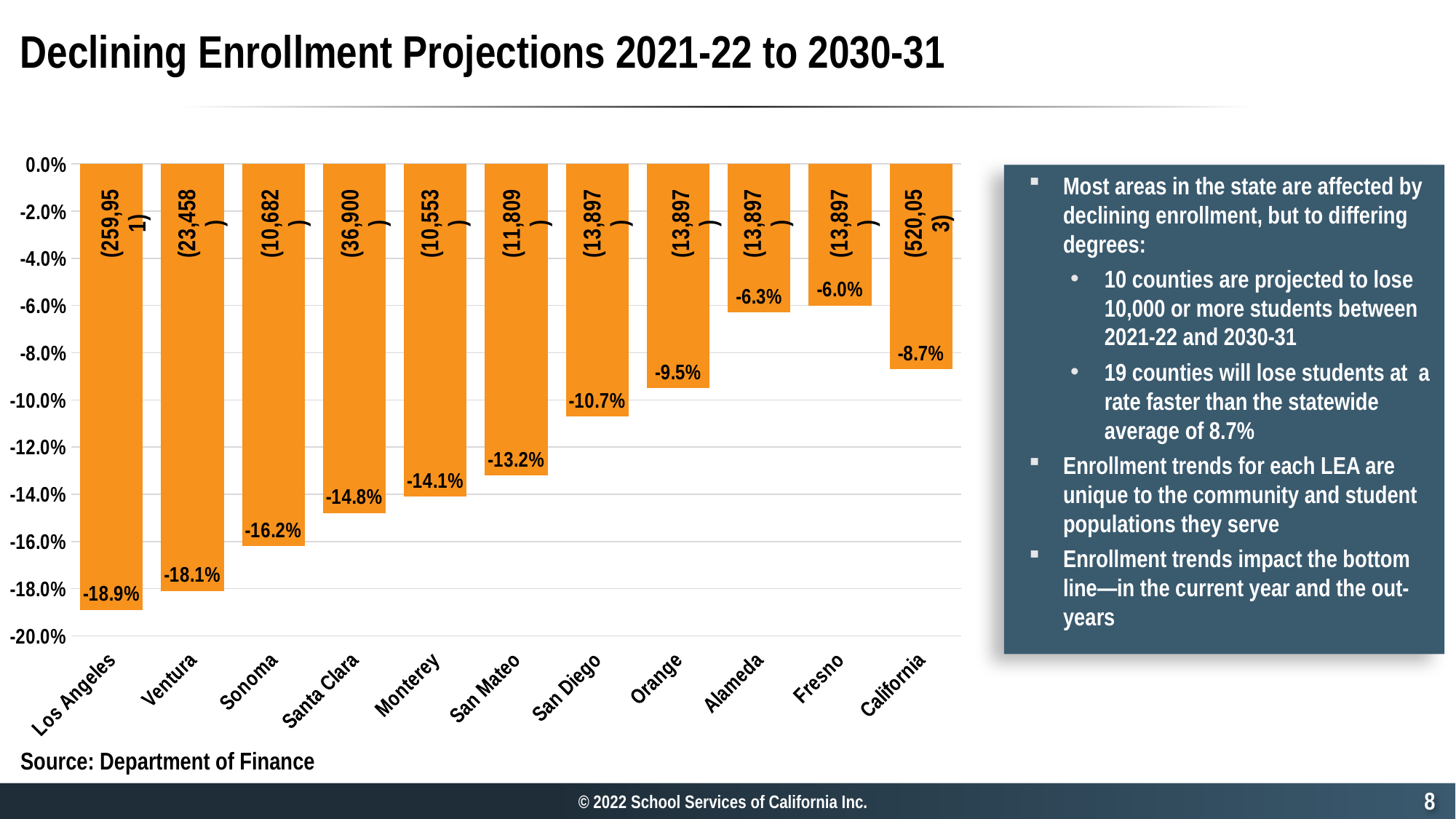
What is the projected enrollment change for Santa Clara? -14.8% What type of chart is shown on the slide? Bar chart What source is cited for the chart data? Department of Finance Which category shows the smallest projected enrollment decline? Fresno Which has a larger projected enrollment decline, San Diego or Orange? San Diego Which county shows the largest projected enrollment decline? Los Angeles What is the projected enrollment change for California as a whole? -8.7% How many categories (bars) are shown in the chart? 11 What is the projected enrollment change for Alameda? -6.3% What is the projected enrollment change for Los Angeles? -18.9% Do the projected decline percentages become smaller or larger in magnitude moving from Los Angeles to Fresno along the x axis? Smaller What is the difference in percentage points between the projected declines for Ventura (-18.1%) and Sonoma (-16.2%)? 1.9 percentage points